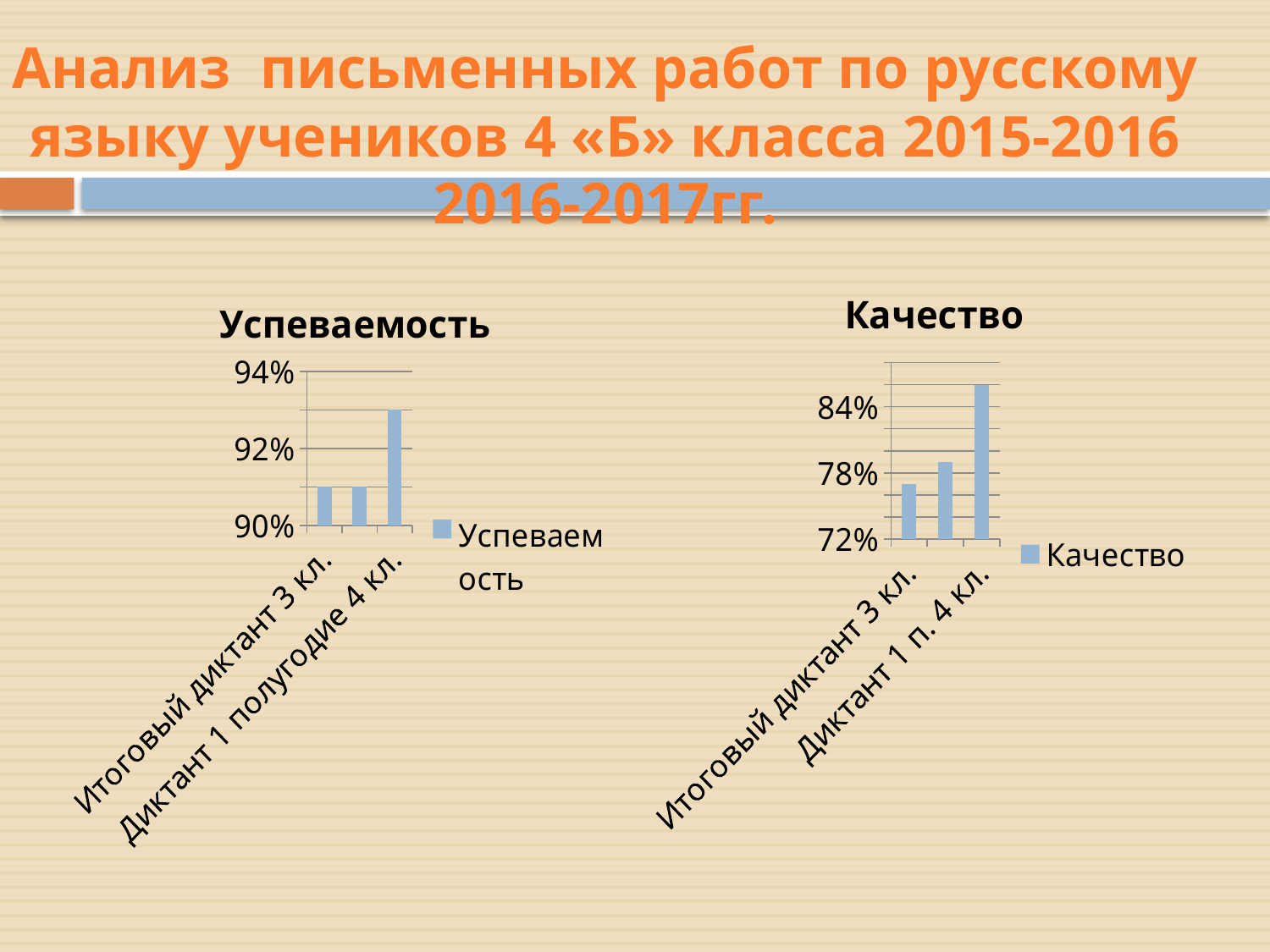
In the "Качество" chart, do the values rise or fall from left to right along the x axis? rise In the "Успеваемость" chart, is the value for "Итоговый диктант 3 кл." greater or less than 92%? less What is the legend entry of the chart on the right? Качество What kind of chart is the "Успеваемость" chart on the left? bar chart How many bars are plotted in the "Успеваемость" chart? 3 In the "Успеваемость" chart, is the value for "Диктант 1 полугодие 4 кл." greater or less than 92%? greater How many series does the legend of the "Качество" chart list? 1 What kind of chart is the "Качество" chart on the right? bar chart In the "Качество" chart, is the value for "Итоговый диктант 3 кл." greater or less than 78%? less In the "Качество" chart, which is larger: the value for "Итоговый диктант 3 кл." or for "Диктант 1 п. 4 кл."? Диктант 1 п. 4 кл. How many bars are plotted in the "Качество" chart? 3 How many series does the legend of the "Успеваемость" chart list? 1